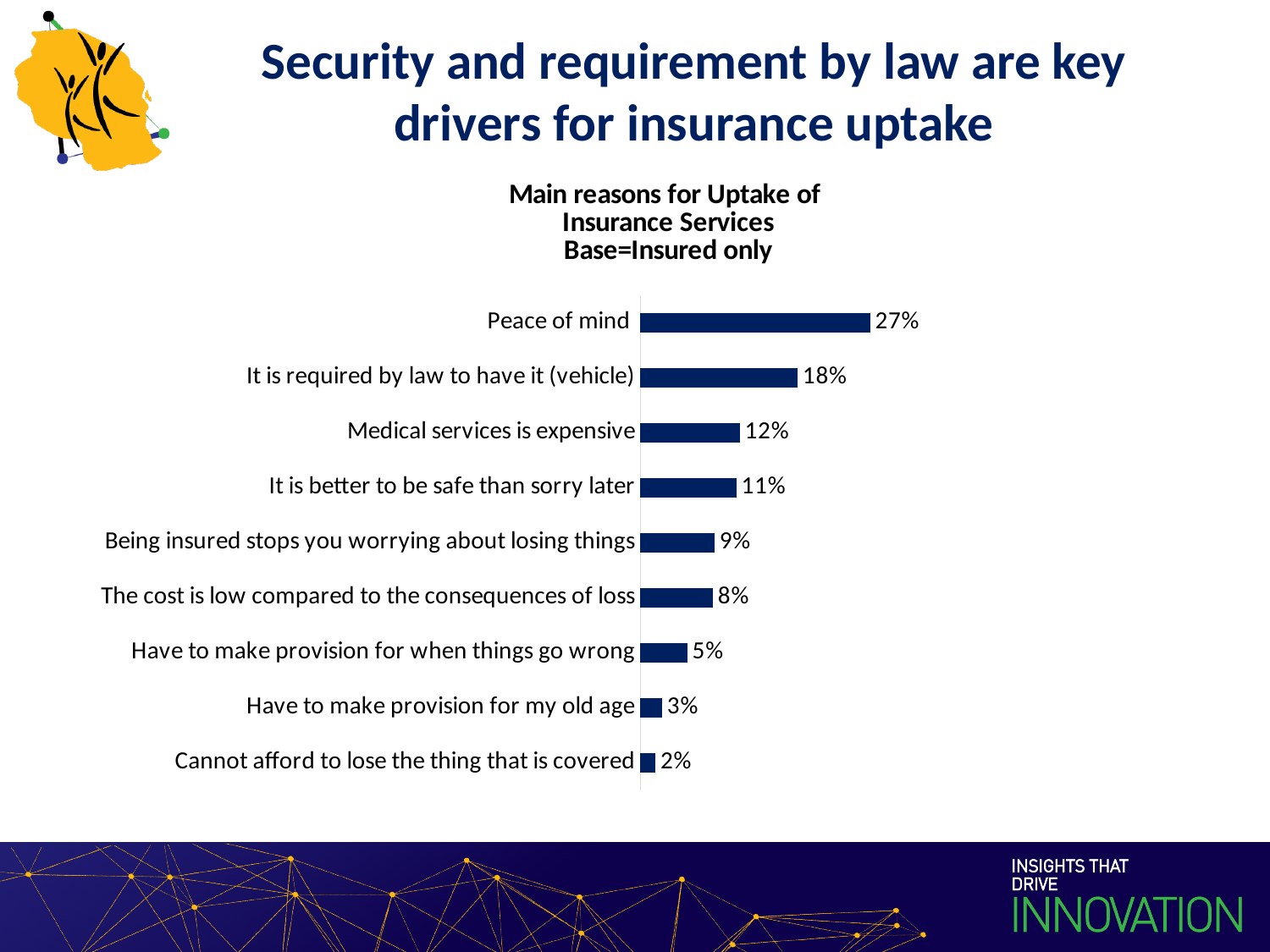
Which reason has the lowest value? Cannot afford to lose the thing that is covered What is the value for "Have to make provision for my old age"? 3% What is the difference between "Being insured stops you worrying about losing things" and "Have to make provision for when things go wrong"? 4% Which reason has the highest value? Peace of mind What is the title of the chart? Main reasons for Uptake of Insurance Services Base=Insured only What is the difference between "Peace of mind" and "It is required by law to have it (vehicle)"? 9% Which is larger: "It is better to be safe than sorry later" or "The cost is low compared to the consequences of loss"? It is better to be safe than sorry later What is the value for "Medical services is expensive"? 12% What kind of chart is shown? Bar chart How many reasons are shown in the chart? 9 What is the value for "It is required by law to have it (vehicle)"? 18% What is the value for "Peace of mind"? 27%